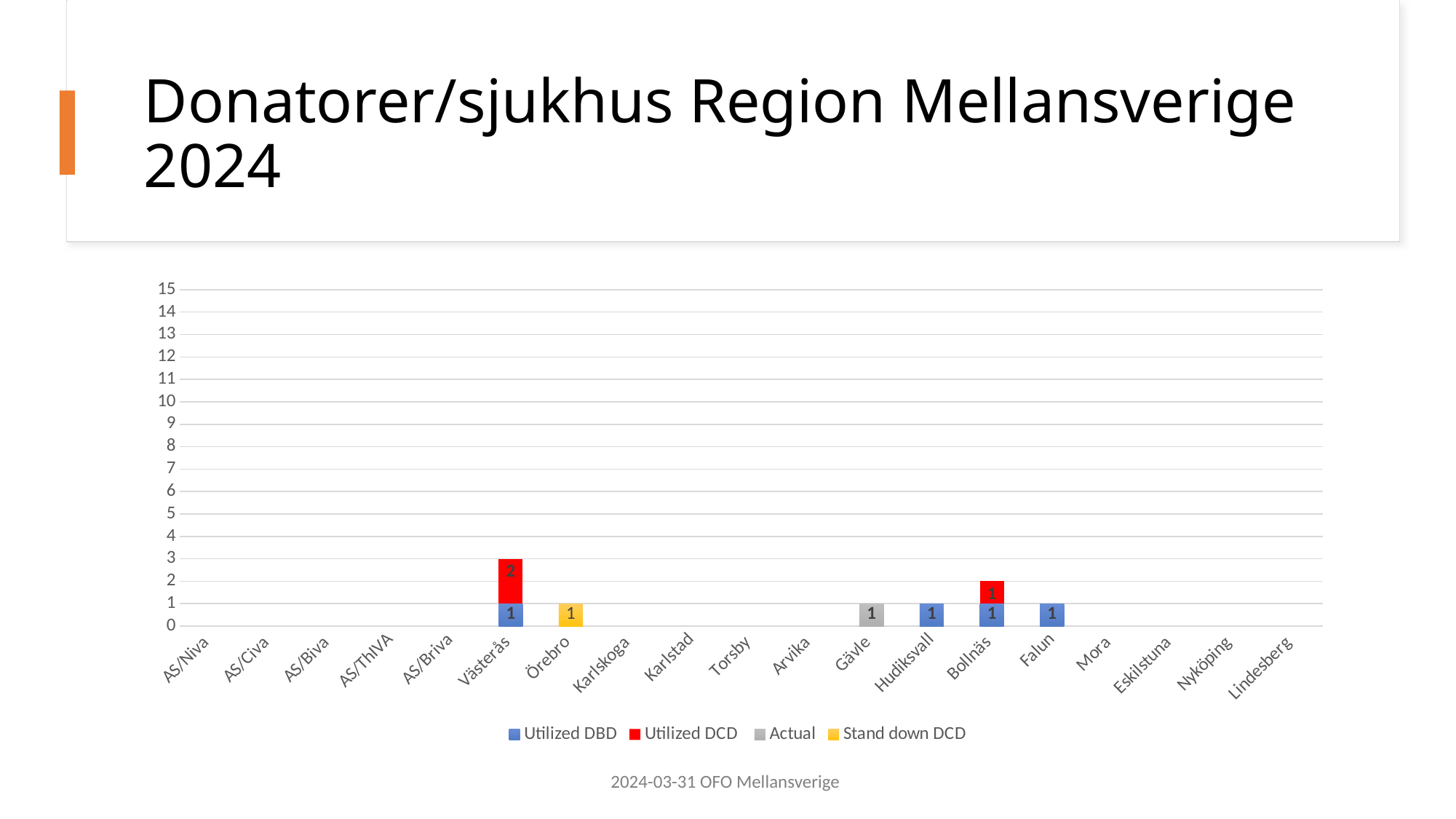
What is the Stand down DCD value for Örebro? 1 How many hospitals are listed on the x axis? 19 What is the Utilized DBD value for Bollnäs? 1 What is the Utilized DCD value for Västerås? 2 What kind of chart is shown on the slide? Stacked bar chart What is the difference between the Utilized DCD value for Västerås and the Utilized DCD value for Bollnäs? 1 Which hospital has the tallest stacked bar? Västerås How many series does the legend list? 4 What is the total of the stacked bar for Bollnäs? 2 What is the total of the stacked bar for Västerås? 3 Which is larger, the stacked total for Västerås or the stacked total for Falun? Västerås What is the Actual value for Gävle? 1